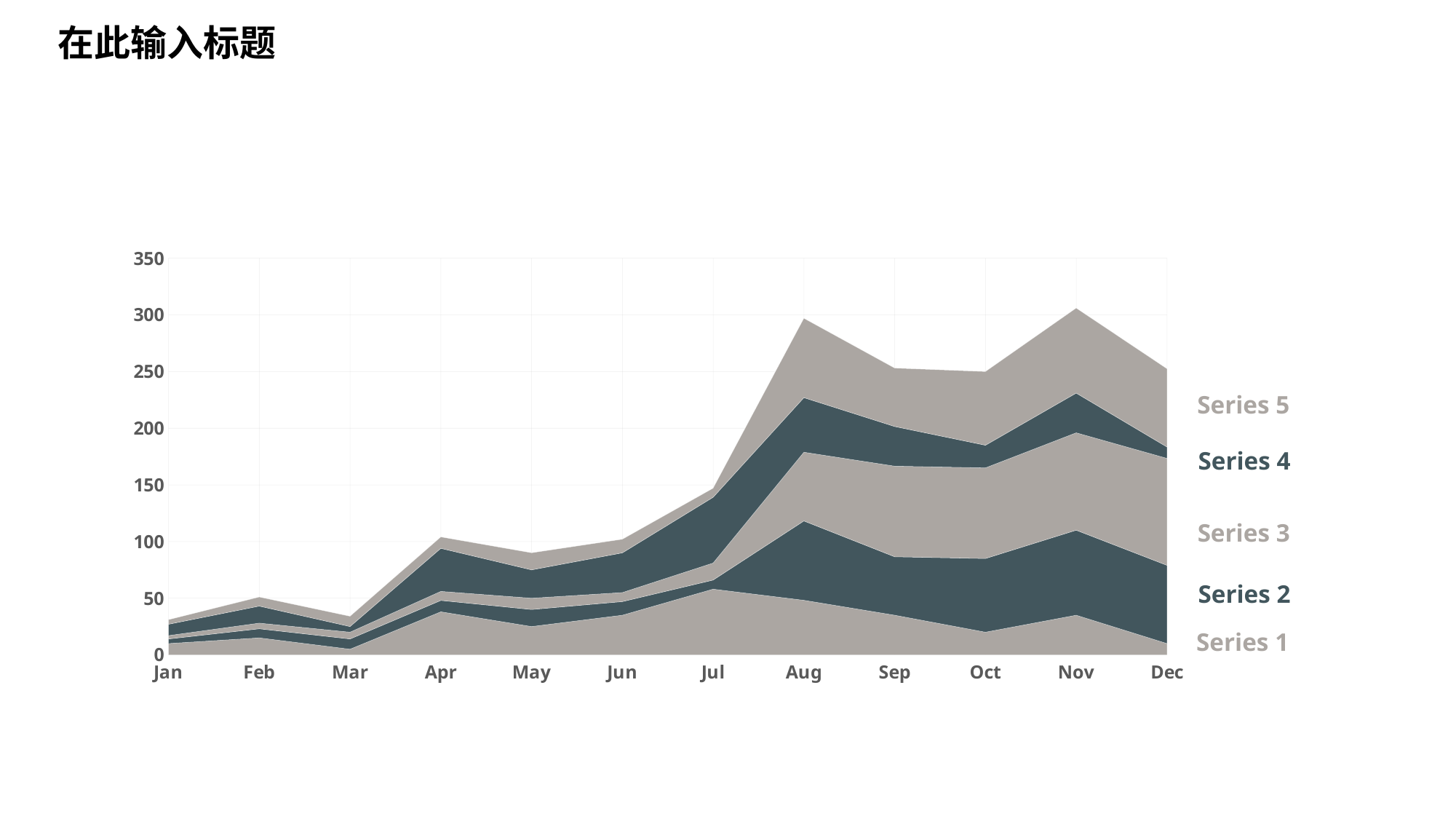
Is the stacked total for Jun greater or less than 150? less What is the label of the topmost series in the stack? Series 5 Does the stacked total generally rise or fall from Jan to Aug? rise Is the stacked total for Sep greater or less than 200? greater Is the stacked total for Mar greater or less than 50? less Which month has the larger stacked total, Nov or Feb? Nov Which month has the larger stacked total, Aug or Mar? Aug What kind of chart is shown on the slide? Stacked area chart How many months are shown along the x axis? 12 How many series does the chart show? 5